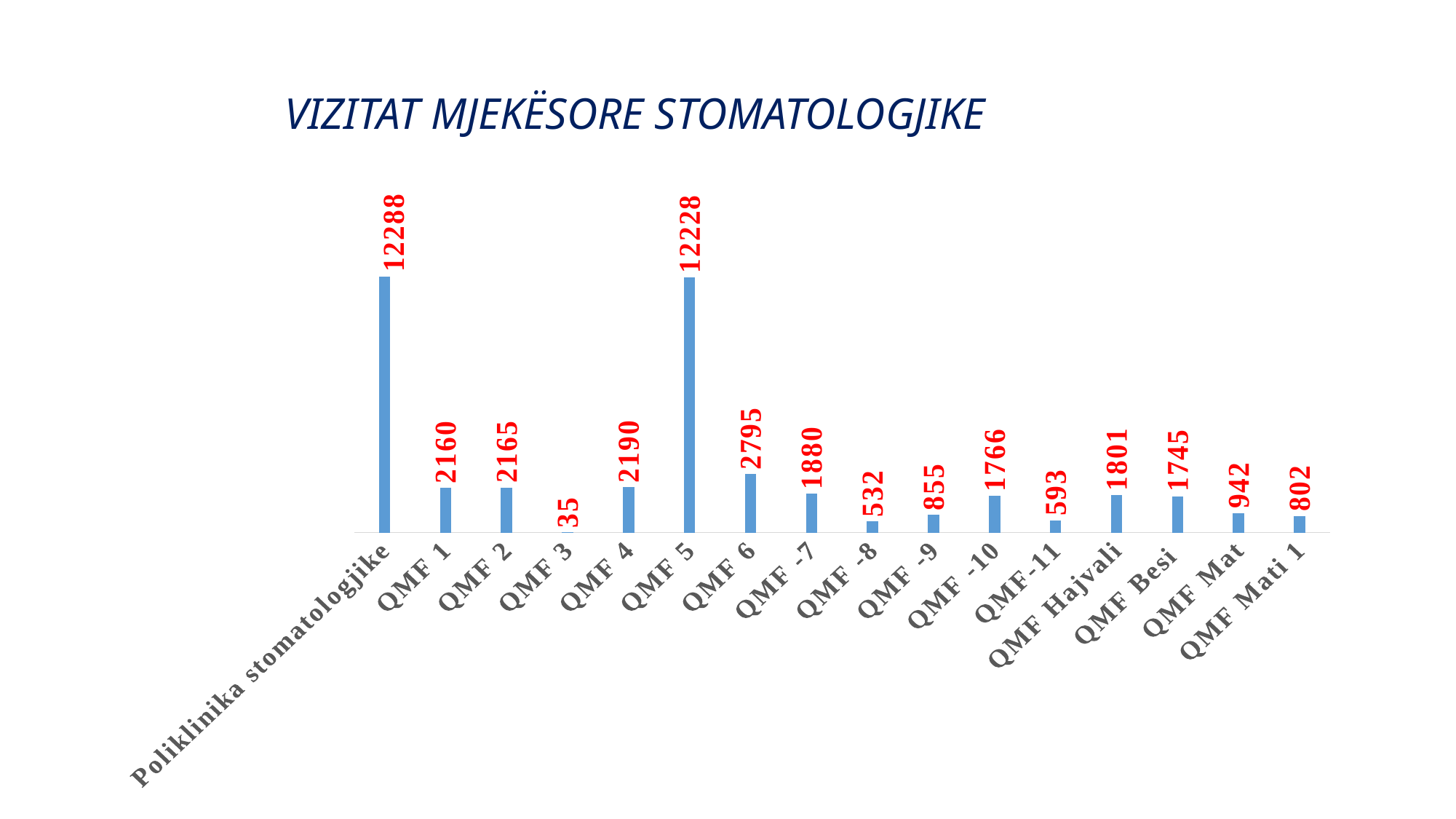
How many categories are shown on the x axis? 16 What is the difference between the values for QMF 6 and QMF -7? 915 What is the value for QMF 6? 2795 What is the title of the chart? VIZITAT MJEKËSORE STOMATOLOGJIKE What is the value for QMF Mat? 942 Which category has the lowest value? QMF 3 What is the value for QMF 3? 35 What is the value for QMF Hajvali? 1801 Which category has the highest value? Poliklinika stomatologjike What is the difference between the values for Poliklinika stomatologjike and QMF 5? 60 Which is larger, the value for QMF -8 or the value for QMF -9? QMF -9 What kind of chart is shown on the slide? Bar chart